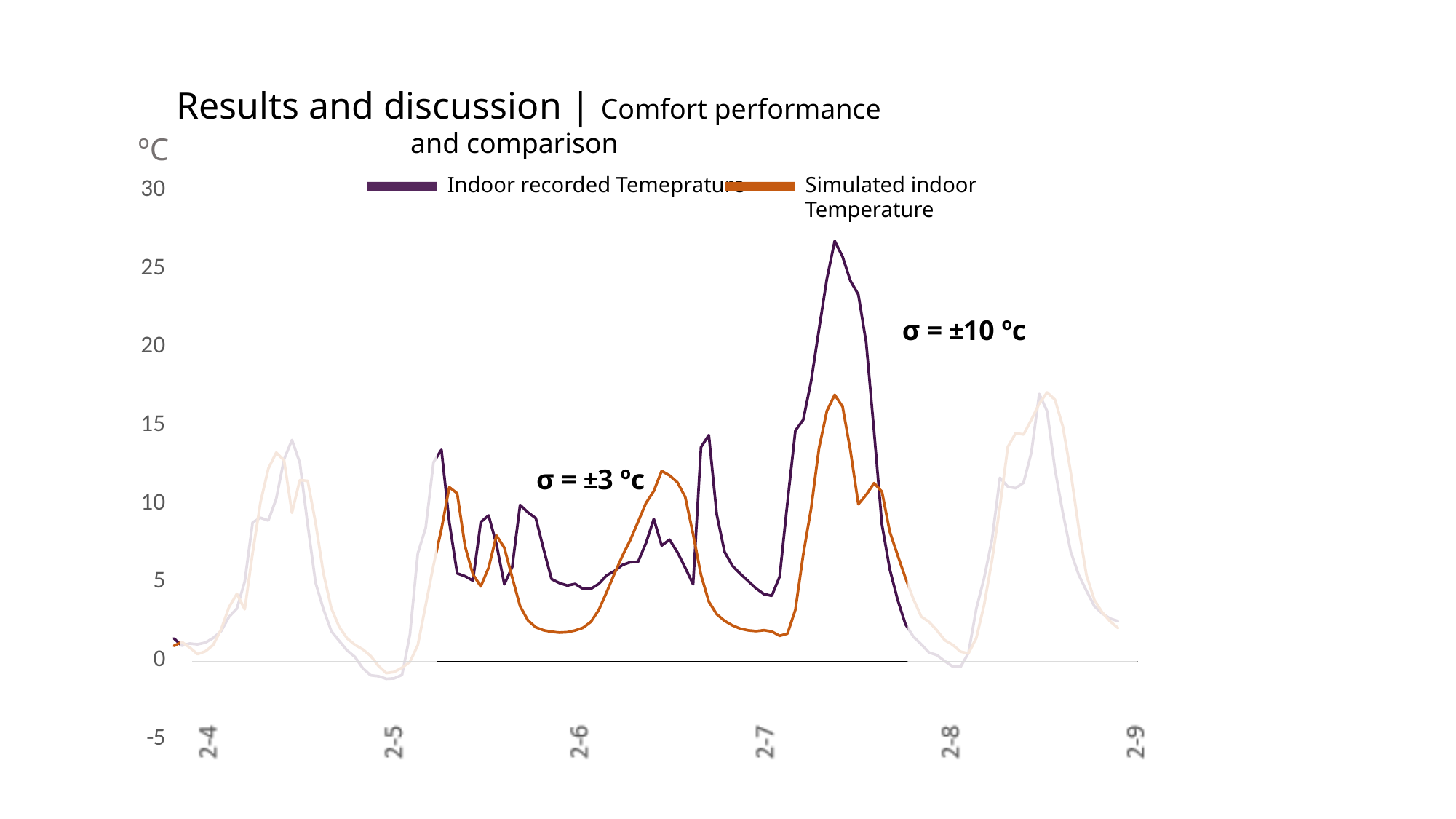
What are the two series named in the legend? Indoor recorded Temeprature; Simulated indoor Temperature Which series reaches the higher peak between 2-7 and 2-8, Indoor recorded Temeprature or Simulated indoor Temperature? Indoor recorded Temeprature What kind of chart is shown on the slide? line chart Is the peak value of the Indoor recorded Temeprature series between 2-7 and 2-8 greater or less than 25? greater Which colour is used for the Simulated indoor Temperature series? orange Is the peak value of the Simulated indoor Temperature series between 2-7 and 2-8 greater or less than 15? greater What is the highest value shown on the y axis? 30 What is the lowest value shown on the y axis? -5 What standard deviation is annotated next to the large peak between 2-7 and 2-8? σ = ±10 °c How many date labels are shown on the x axis? 6 How many series does the legend list? 2 Is the lowest value of the Simulated indoor Temperature series around 2-6 greater or less than 5? less